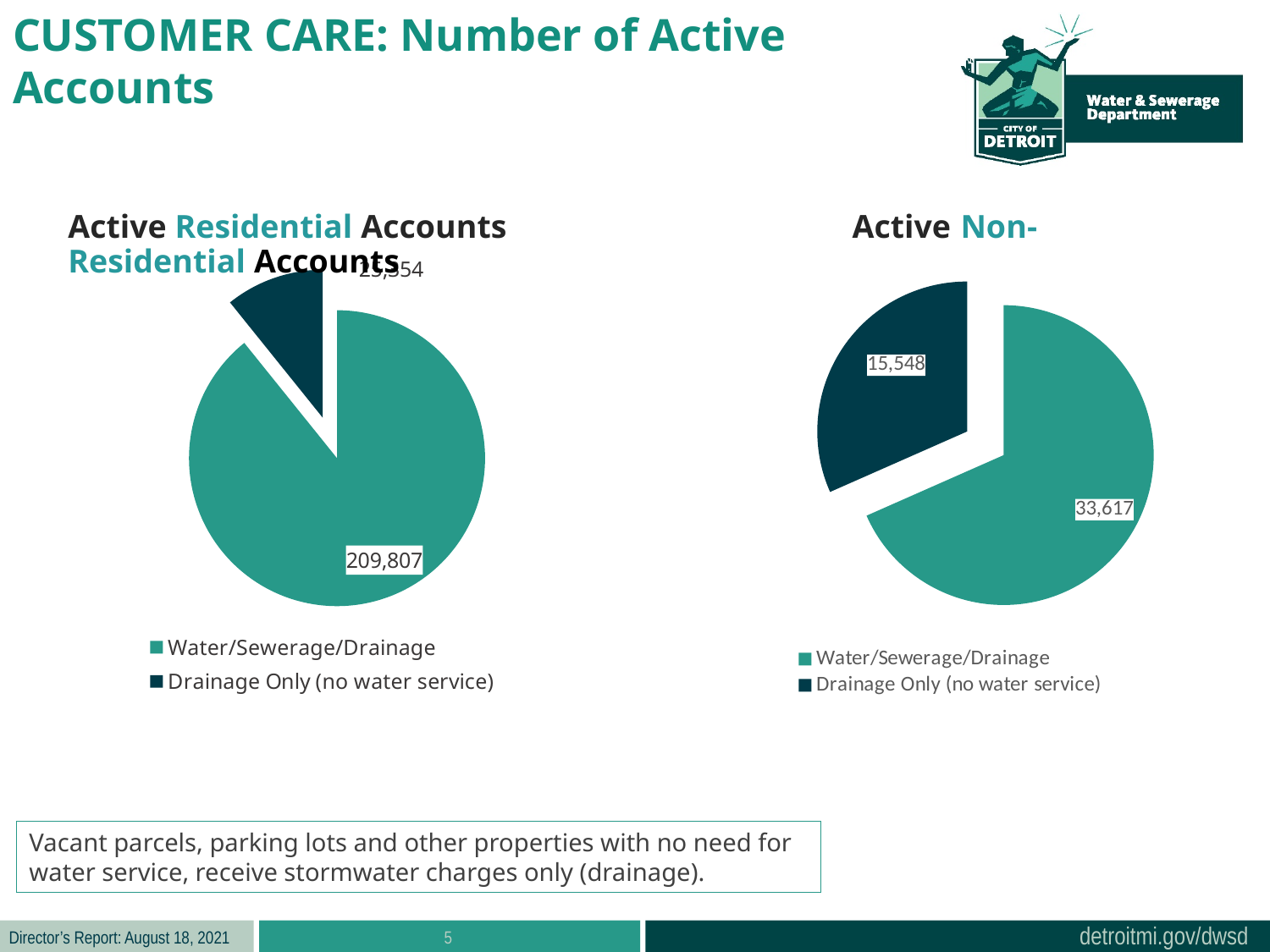
In the Active Non-Residential Accounts chart, which category has the largest slice? Water/Sewerage/Drainage In the Active Non-Residential Accounts chart, what colour is the Drainage Only (no water service) slice? Dark teal In the Active Non-Residential Accounts chart, what is the difference between the Water/Sewerage/Drainage and Drainage Only (no water service) values? 18,069 In the Active Non-Residential Accounts chart, which category has the smallest slice? Drainage Only (no water service) In the Active Non-Residential Accounts chart, what is the value for Drainage Only (no water service)? 15,548 How many slices does the Active Residential Accounts pie chart have? 2 Which is larger: Water/Sewerage/Drainage in the Active Residential Accounts chart or Water/Sewerage/Drainage in the Active Non-Residential Accounts chart? Active Residential Accounts What type of chart is used for Active Non-Residential Accounts? Pie chart How many entries does the legend of the Active Non-Residential Accounts chart list? 2 In the Active Residential Accounts chart, what is the value for Water/Sewerage/Drainage? 209,807 In the Active Residential Accounts chart, which category has the largest slice? Water/Sewerage/Drainage In the Active Non-Residential Accounts chart, what is the value for Water/Sewerage/Drainage? 33,617